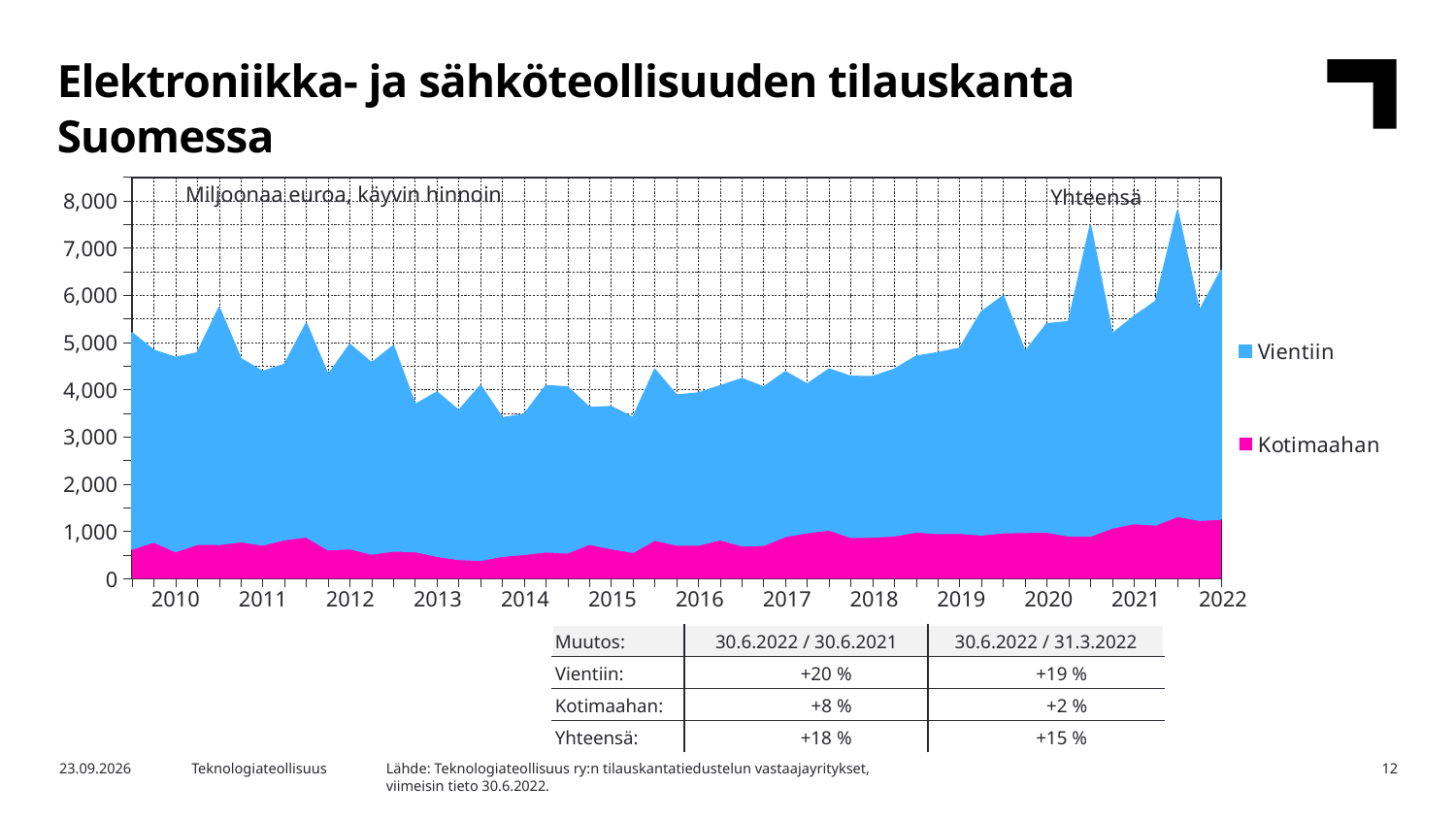
How many series does the chart's legend list? 2 Is the Kotimaahan value in 2022 greater or less than 2,000? less Is the Kotimaahan value in 2022 greater or less than 1,000? greater What unit label is printed inside the chart area? Miljoonaa euroa, käyvin hinnoin How many year labels are shown on the x axis? 13 Is the total (Yhteensä) value in 2015 greater or less than 5,000? less What kind of chart is shown on the slide? area chart Does the total (Yhteensä) generally rise or fall from 2019 to 2022? rise Which two series are listed in the chart's legend? Vientiin and Kotimaahan In 2022, which series is larger, Vientiin or Kotimaahan? Vientiin